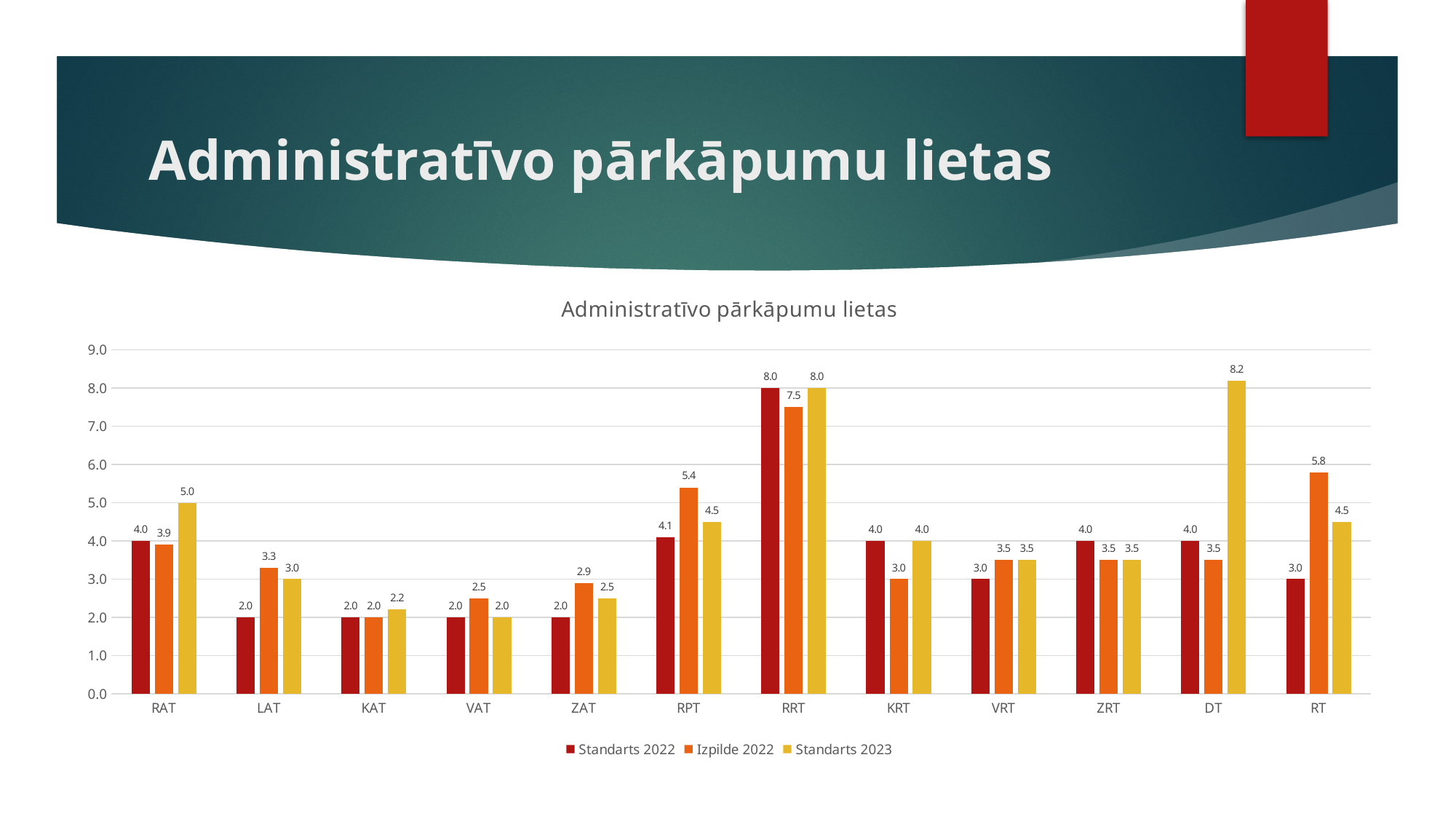
What is the Standarts 2023 value for DT? 8.2 Which category has the highest Standarts 2023 value? DT Which is larger for LAT: the Izpilde 2022 value or the Standarts 2023 value? Izpilde 2022 How many series does the legend list? 3 Which category has the highest Izpilde 2022 value? RRT What is the Standarts 2022 value for RRT? 8.0 What is the difference between the Standarts 2023 and Standarts 2022 values for DT? 4.2 How many categories are shown on the x axis? 12 What kind of chart is shown on the slide? Bar chart What is the title of the chart? Administratīvo pārkāpumu lietas What is the Izpilde 2022 value for RPT? 5.4 What is the difference between the Izpilde 2022 and Standarts 2022 values for RT? 2.8